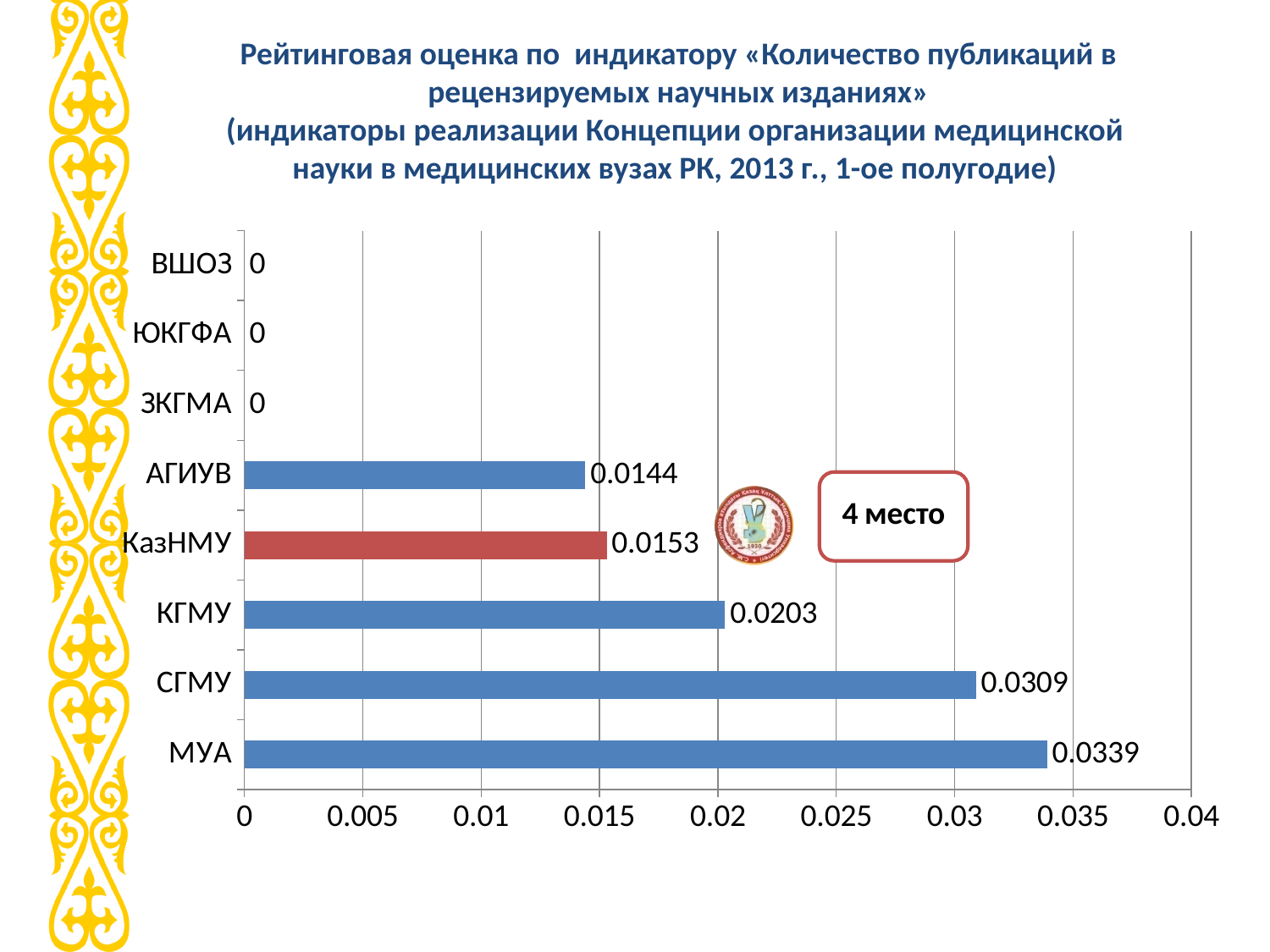
What kind of chart is shown on the slide? bar chart What is the value for КазНМУ? 0.0153 What is the difference between the values for КГМУ and КазНМУ? 0.0050 How many categories are shown on the chart? 8 Is the value for СГМУ greater or less than 0.03? greater What is the value for АГИУВ? 0.0144 What is the value for КГМУ? 0.0203 What is the difference between the values for МУА and СГМУ? 0.0030 Which bar is coloured red rather than blue? КазНМУ Which is larger, the value for СГМУ or the value for КГМУ? СГМУ What is the value for МУА? 0.0339 Which category has the highest value? МУА